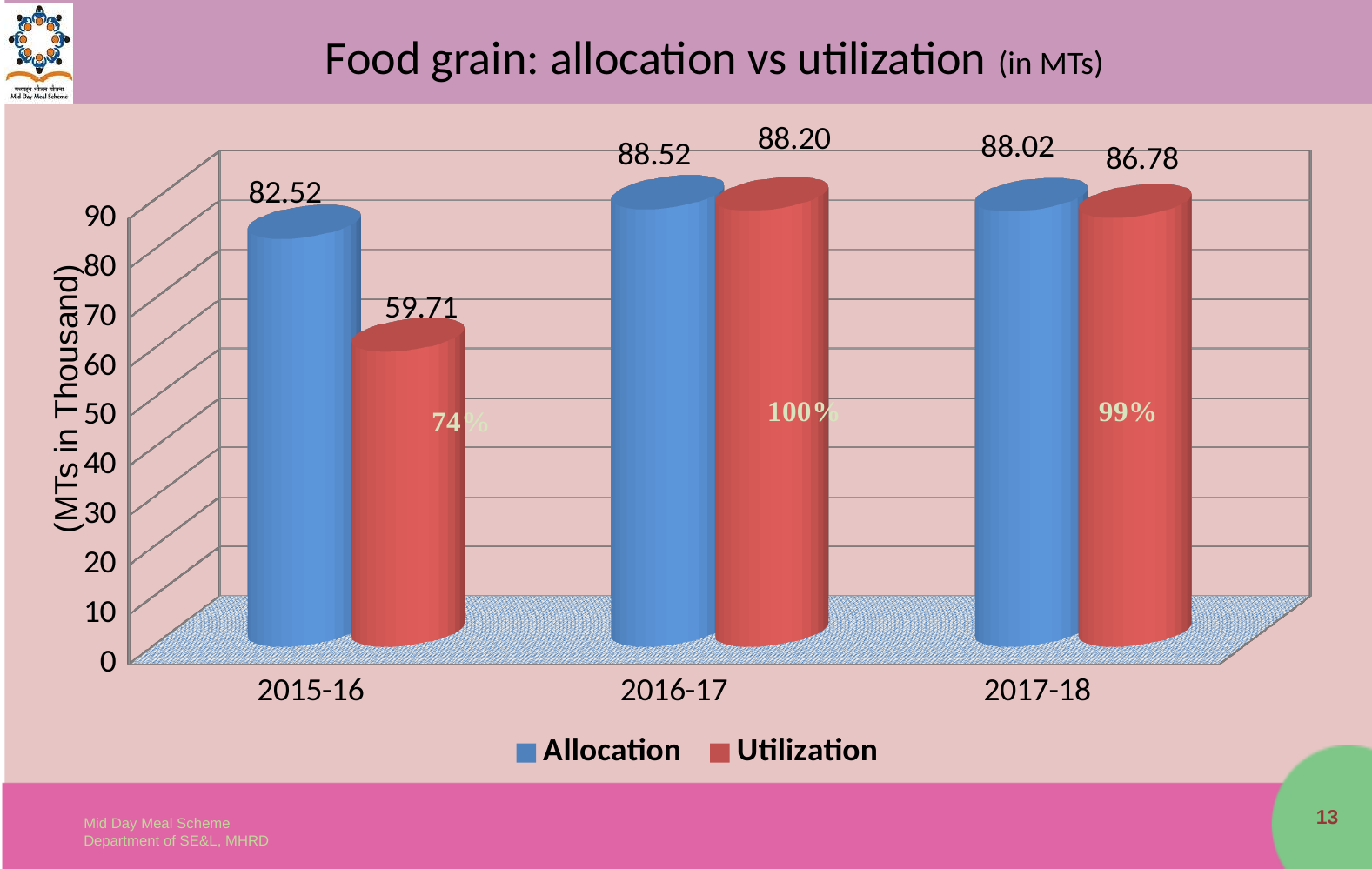
What is the difference between Allocation and Utilization in 2015-16? 22.81 What kind of chart is shown on the slide? Bar chart What percentage label is shown on the Utilization bar for 2016-17? 100% Which year has the highest Allocation value? 2016-17 Which year has the lowest Utilization value? 2015-16 How many series does the legend list? 2 What is the Utilization value for 2016-17? 88.20 How many years are shown on the x axis? 3 Does the Utilization value rise or fall from 2015-16 to 2016-17? Rise What is the Allocation value for 2015-16? 82.52 Which is larger in 2017-18, Allocation or Utilization? Allocation What is the Utilization value for 2017-18? 86.78